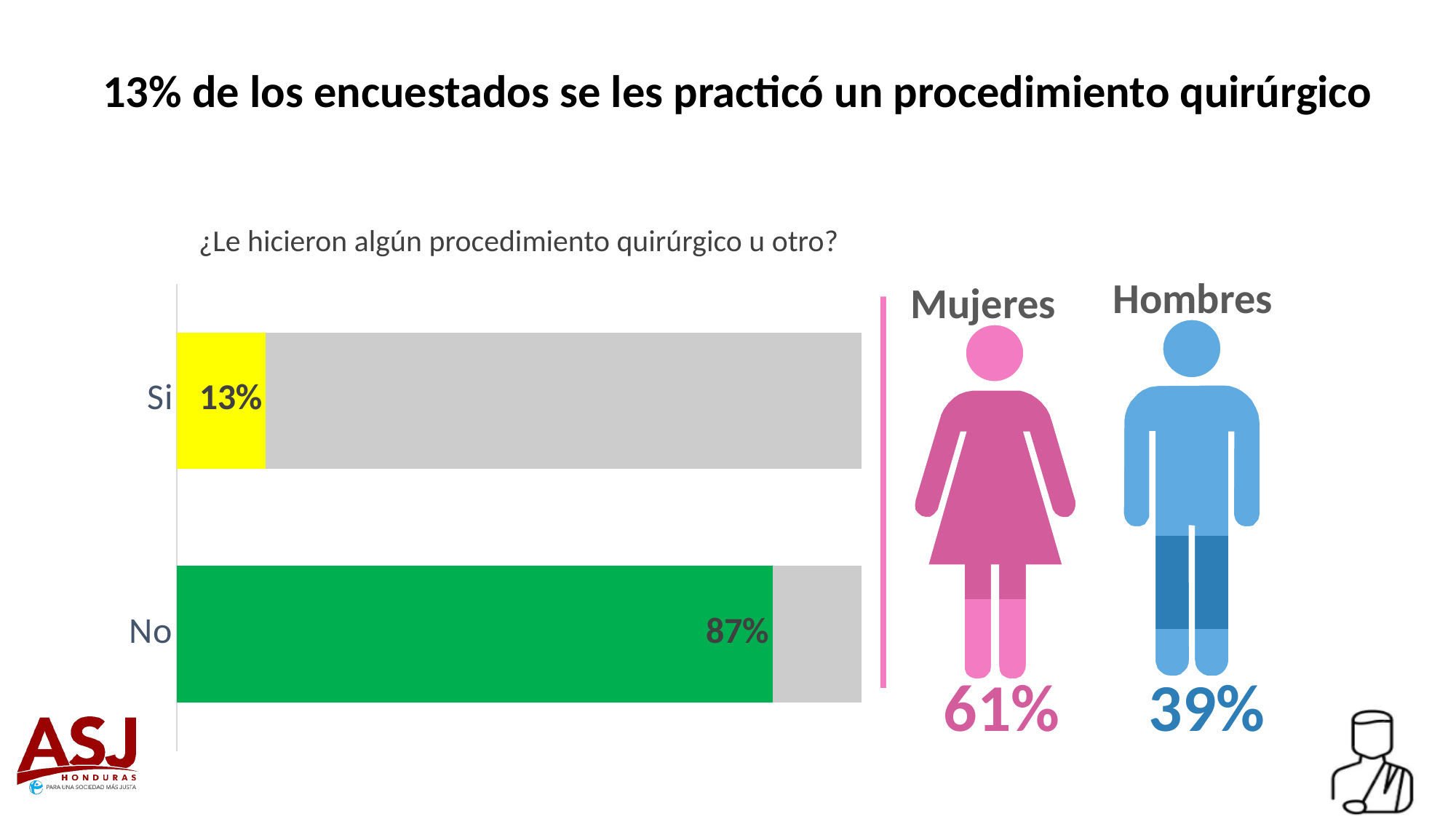
In the bar chart, what is the difference between the values for "No" and "Si"? 74% In the bar chart, which is larger, the value for "Si" or the value for "No"? No What kind of chart is shown under the question "¿Le hicieron algún procedimiento quirúrgico u otro?"? Bar chart In the bar chart, what is the value for "No"? 87% In the bar chart, which category has the highest value? No In the pictogram on the right of the slide, what is the difference between the "Mujeres" and "Hombres" percentages? 22% In the pictogram on the right of the slide, what percentage is shown for "Mujeres"? 61% What colour is the "No" bar in the bar chart? Green What is the total of the "Si" and "No" values in the bar chart? 100% In the bar chart, what is the value for "Si"? 13% How many categories does the bar chart show? 2 In the bar chart, which category has the lowest value? Si